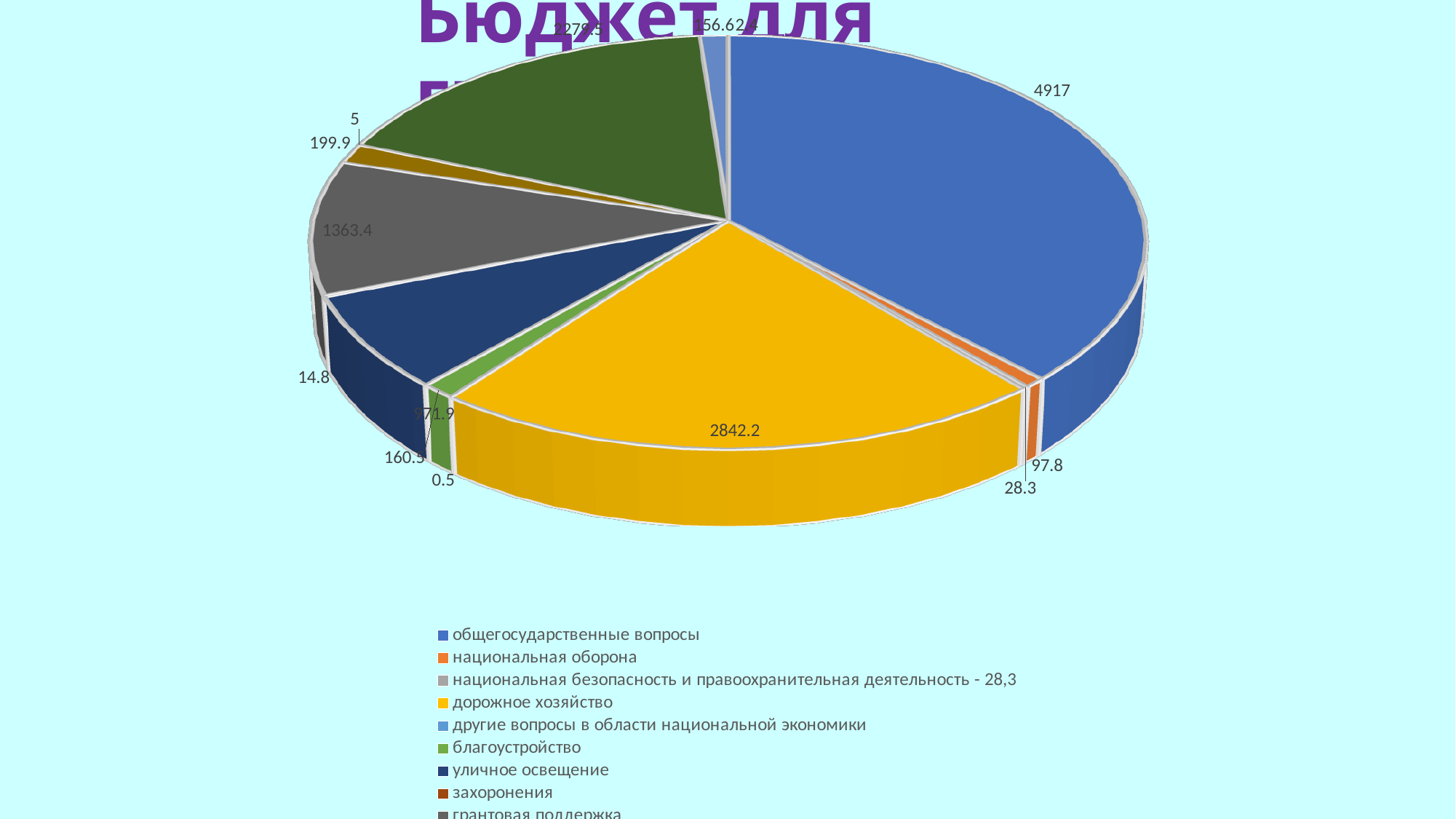
Which is larger: the дорожное хозяйство slice or the уличное освещение slice? дорожное хозяйство What is the first entry listed in the legend? общегосударственные вопросы Which is larger: the уличное освещение slice or the благоустройство slice? уличное освещение What value is labelled on the национальная оборона slice? 97.8 What is the difference between the общегосударственные вопросы value (4917) and the дорожное хозяйство value (2842.2)? 2074.8 What colour is the дорожное хозяйство slice? yellow Which category has the largest slice of the pie? общегосударственные вопросы What value is labelled on the дорожное хозяйство slice? 2842.2 What value is labelled on the уличное освещение slice? 971.9 What kind of chart is shown on the slide? pie chart What is the value shown for the largest slice (общегосударственные вопросы)? 4917 What value is labelled on the благоустройство slice? 160.5